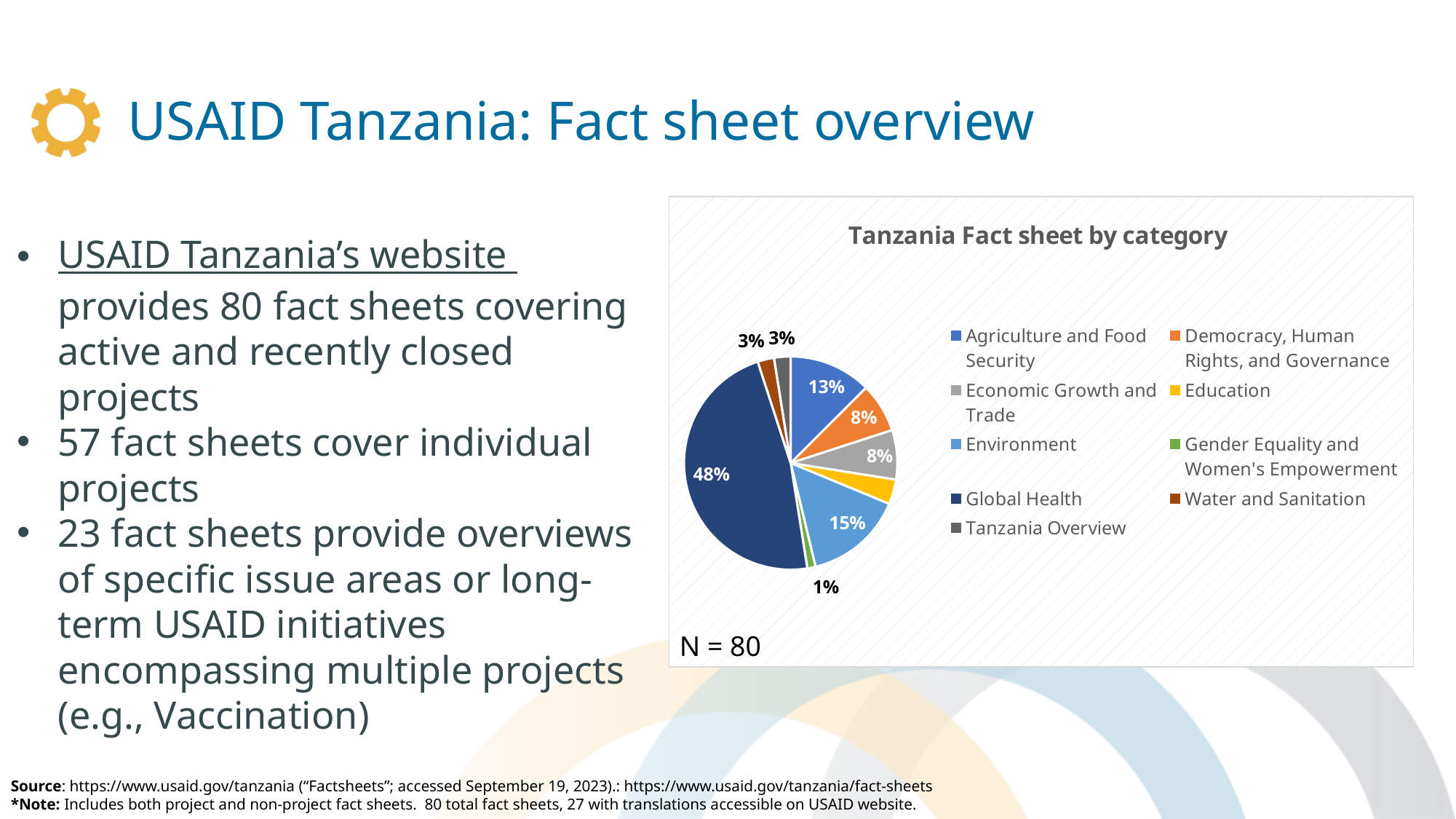
What share of the pie does Global Health represent? 48% Which category has the largest share of the pie? Global Health What sample size (N) is noted on the chart? N = 80 What is the title of the chart? Tanzania Fact sheet by category How many percentage points larger is Global Health than Environment? 33 What percentage is shown for Gender Equality and Women's Empowerment? 1% Which is larger, Agriculture and Food Security or Democracy, Human Rights, and Governance? Agriculture and Food Security How many categories does the legend list? 9 What percentage of fact sheets are in the Environment category? 15% What is the value shown for Agriculture and Food Security? 13% Which category has the smallest share of the pie? Gender Equality and Women's Empowerment What type of chart is shown on the slide? Pie chart